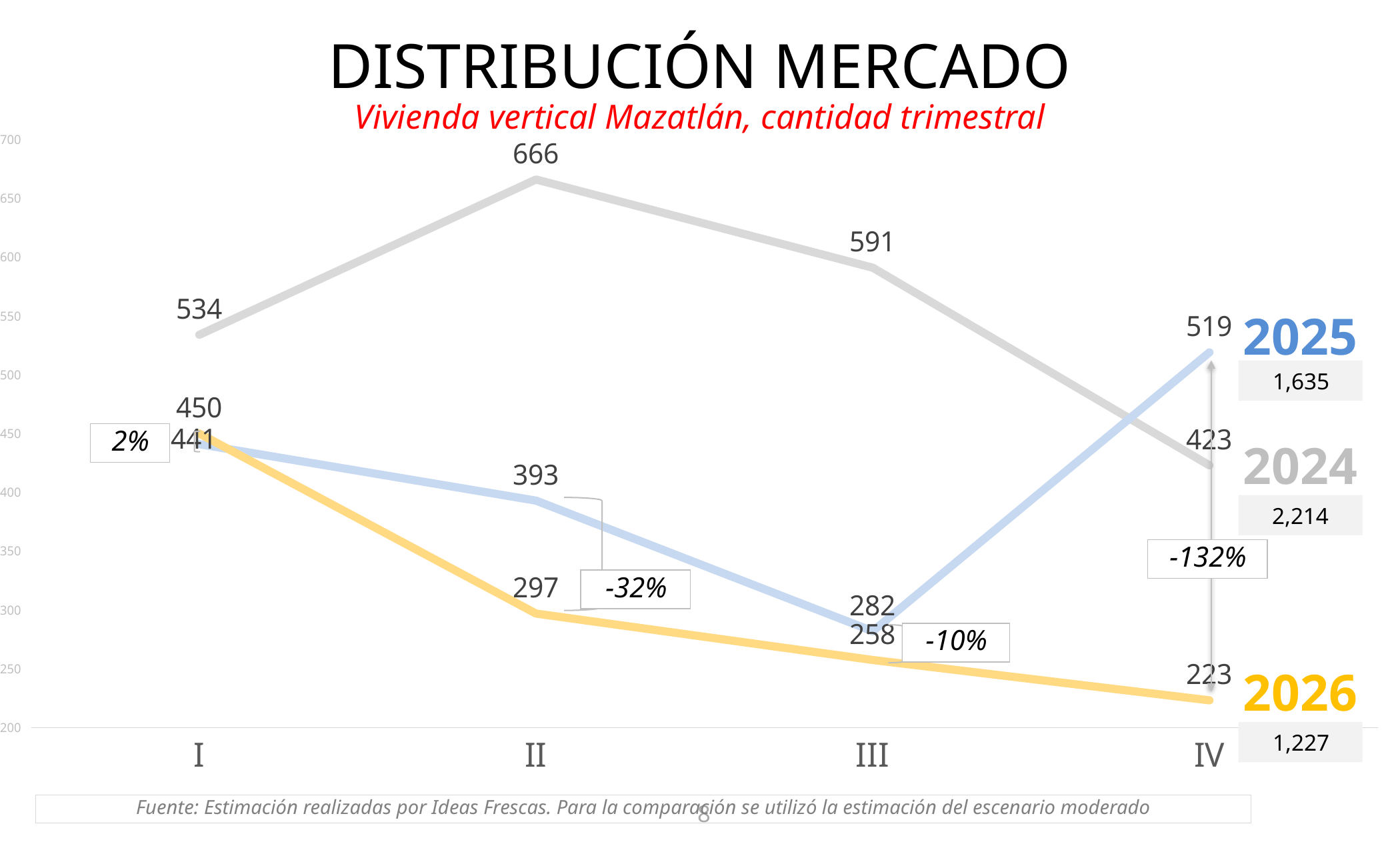
In which quarter does the 2026 series reach its lowest value? IV How many quarters are shown on the x axis? 4 What type of chart is shown on the slide? line chart What is the difference between the 2024 values in quarter II and quarter III? 75 What is the value for 2026 in quarter IV? 223 In which quarter does the 2024 series reach its highest value? II What is the value for 2024 in quarter II? 666 What is the value for 2025 in quarter IV? 519 Which is larger in quarter IV: the 2025 value or the 2024 value? 2025 What annual total is shown next to the 2024 label? 2,214 What is the value for 2024 in quarter IV? 423 How many series (years) are plotted on the chart? 3